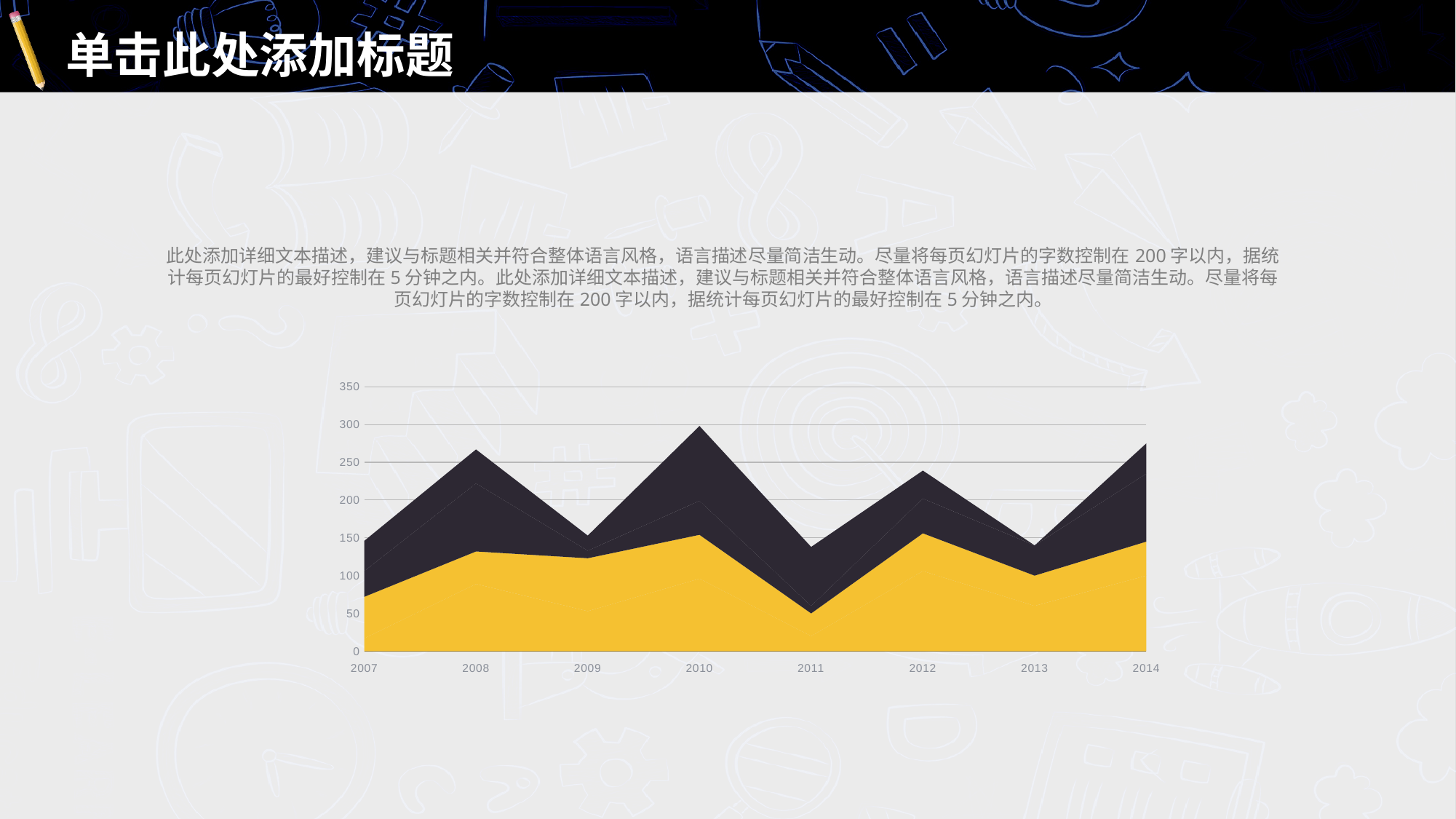
In which year does the top of the dark series reach its highest value? 2010 Is the value of the yellow series for 2011 greater or less than 100? less What is the first year shown on the x axis? 2007 What kind of chart is shown on the slide? Area chart Does the yellow series rise or fall from 2010 to 2011? fall Is the top of the dark series for 2010 greater or less than 250? greater In which year does the yellow series reach its lowest value? 2011 Is the top of the dark series for 2011 greater or less than 200? less How many years are shown on the x axis of the chart? 8 What is the highest value shown on the y axis? 350